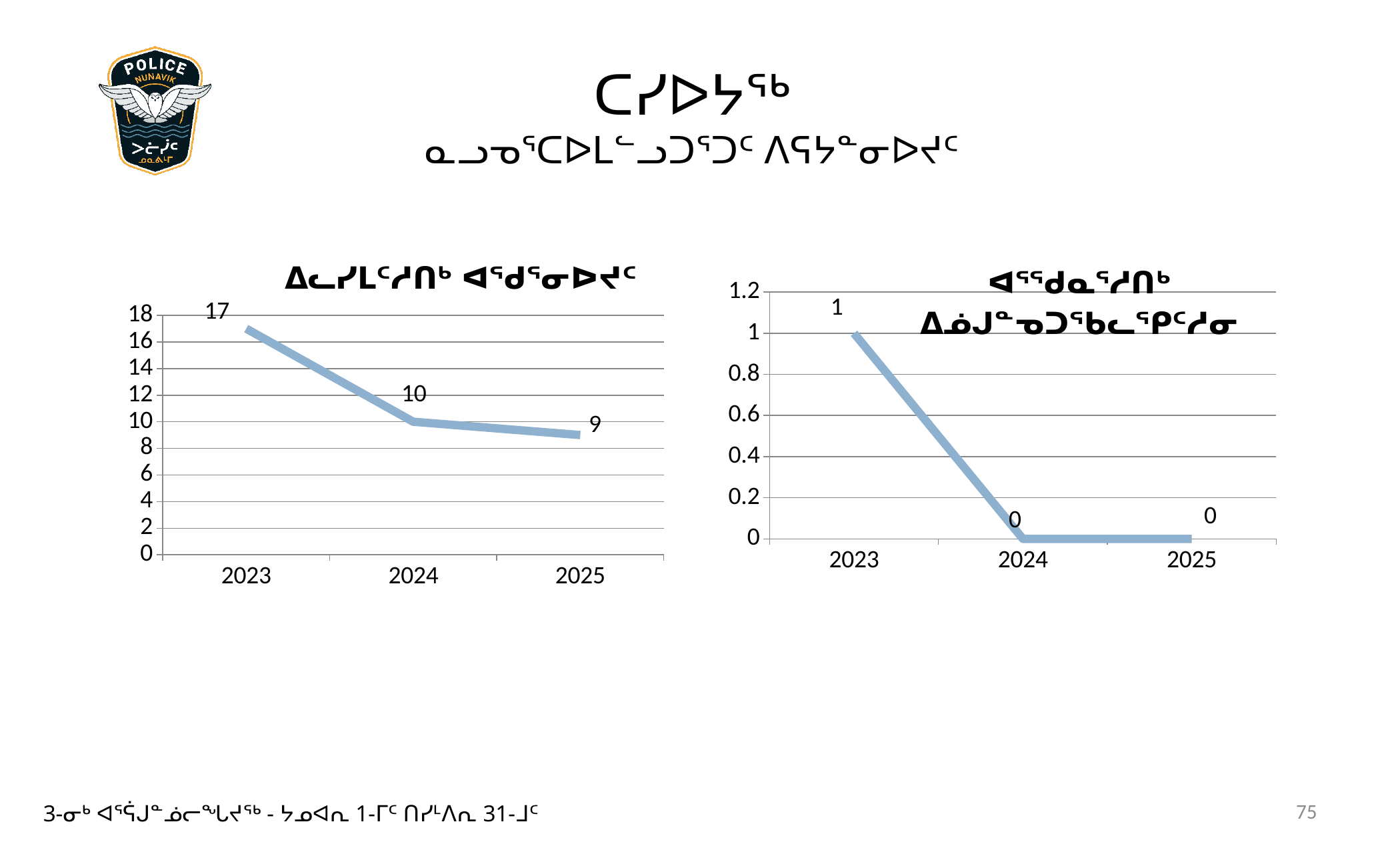
In the left chart, what is the difference between the values for 2023 and 2024? 7 In the left chart, which year has the lowest value? 2025 In the right chart, which year has the highest value? 2023 In the left chart, what is the value for 2025? 9 In the left chart, what is the value for 2023? 17 In the right chart, what is the value for 2023? 1 In the right chart, what is the value for 2024? 0 In the left chart, what is the value for 2024? 10 In the left chart, which year has the highest value? 2023 In the left chart, do the values rise or fall from 2023 to 2025? fall How many years are plotted in the right chart? 3 What kind of chart is the left chart? line chart